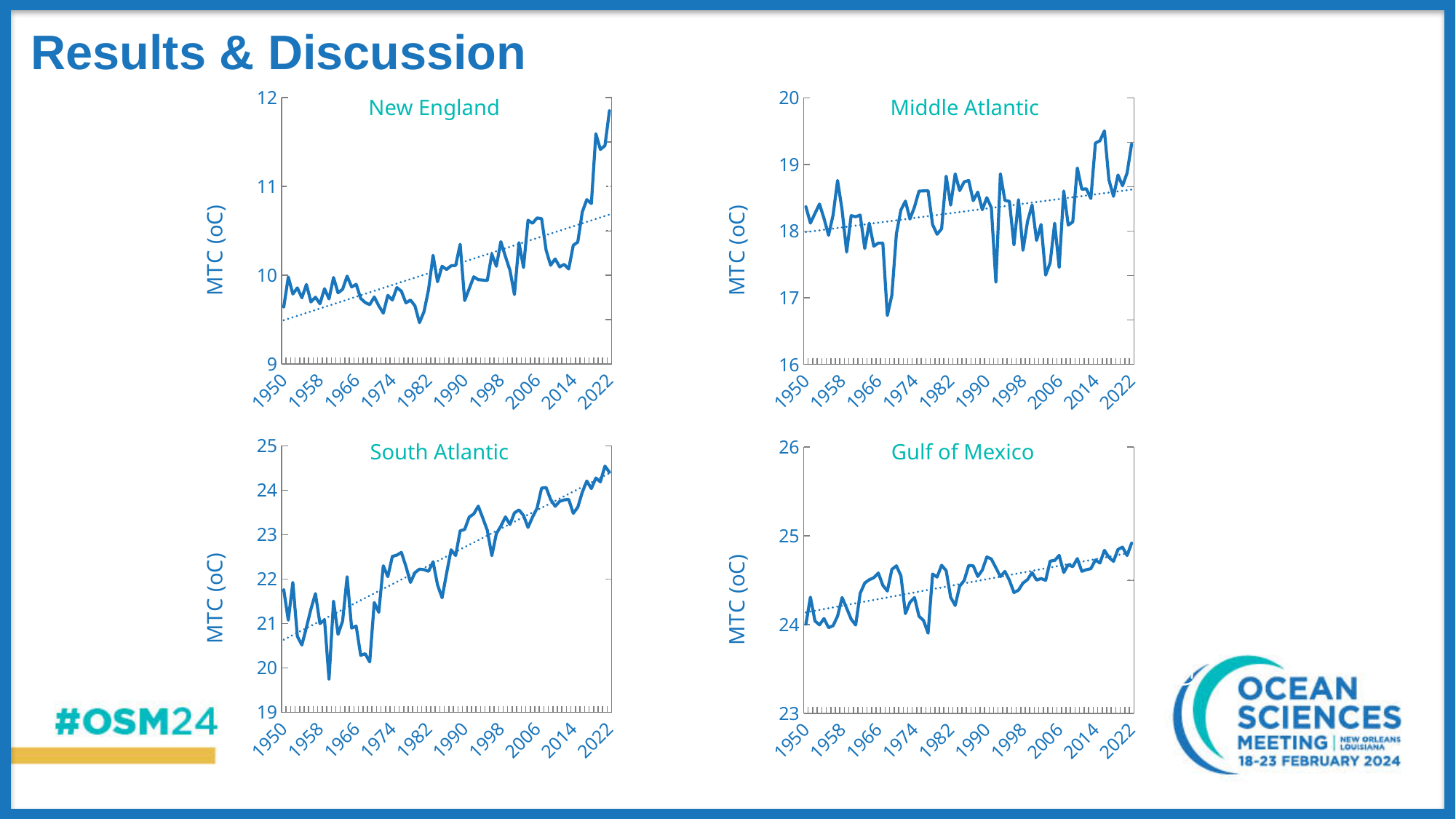
How many charts are shown on the slide? 4 In the South Atlantic chart, is the value for 2022 greater or less than 24? greater In the South Atlantic chart, do the values generally rise or fall along the x axis? rise In the New England chart, is the value for 2022 greater or less than 11? greater What is the title of the chart in the bottom-right position of the slide? Gulf of Mexico In the Gulf of Mexico chart, do the values generally rise or fall from 1950 to 2022? rise In the New England chart, do the values generally rise or fall from 1950 to 2022? rise In the Middle Atlantic chart, is the lowest value (around 1970) greater or less than 17? less What is the y-axis label on the Middle Atlantic chart? MTC (oC) What kind of chart is the New England chart? line chart